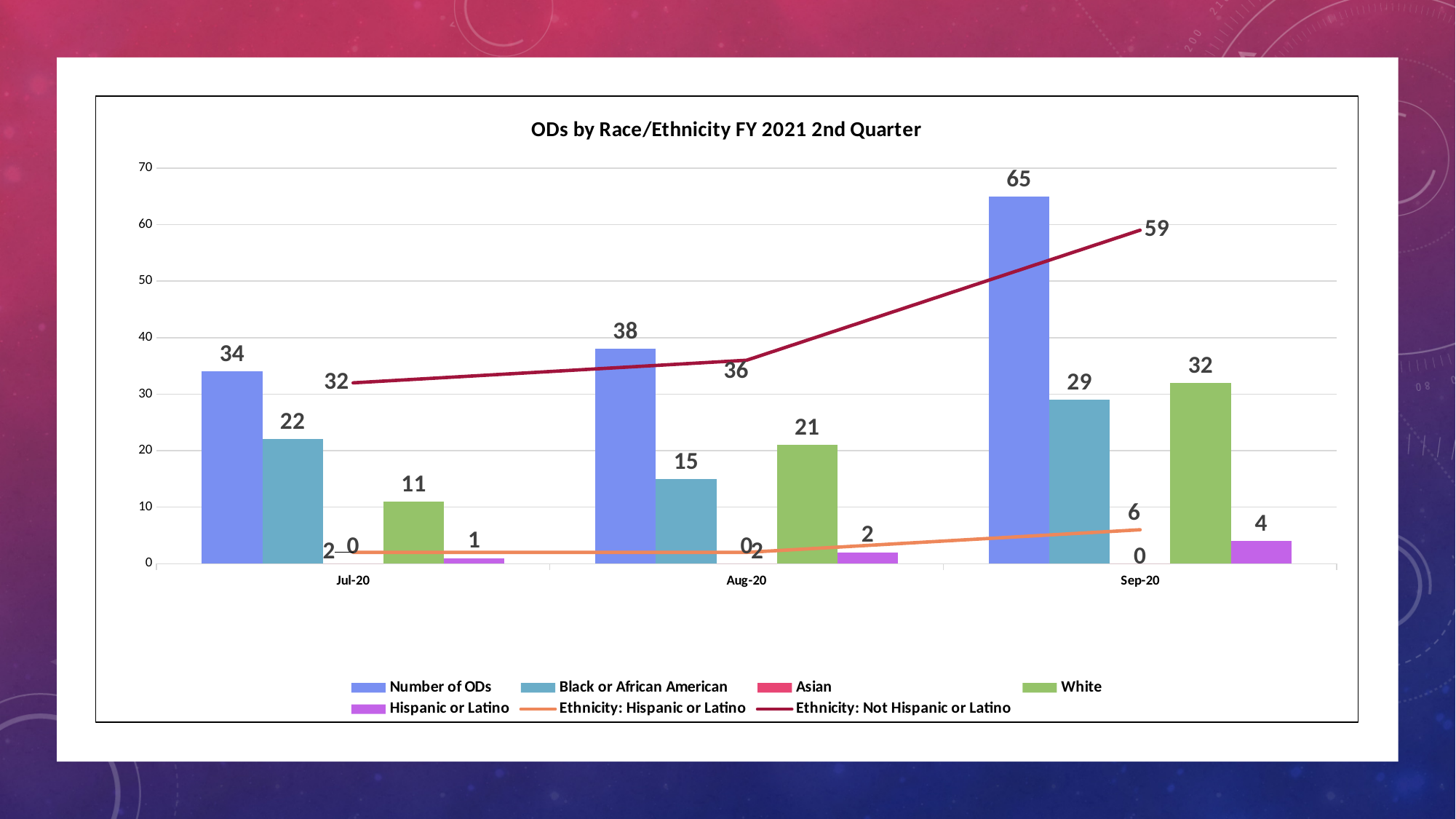
What is the value of Number of ODs for Sep-20? 65 How many series does the legend list? 7 What kind of chart is this? Combined bar and line chart What is the difference between Number of ODs in Sep-20 and Jul-20? 31 How many months are shown on the x axis? 3 What is the value of the Ethnicity: Not Hispanic or Latino line for Sep-20? 59 Does Number of ODs rise or fall from Jul-20 to Sep-20? Rise What is the value for White in Aug-20? 21 What is the value for Black or African American in Jul-20? 22 In which month is the Black or African American value lowest? Aug-20 In Sep-20, which is larger: White or Black or African American? White In which month is Number of ODs highest? Sep-20